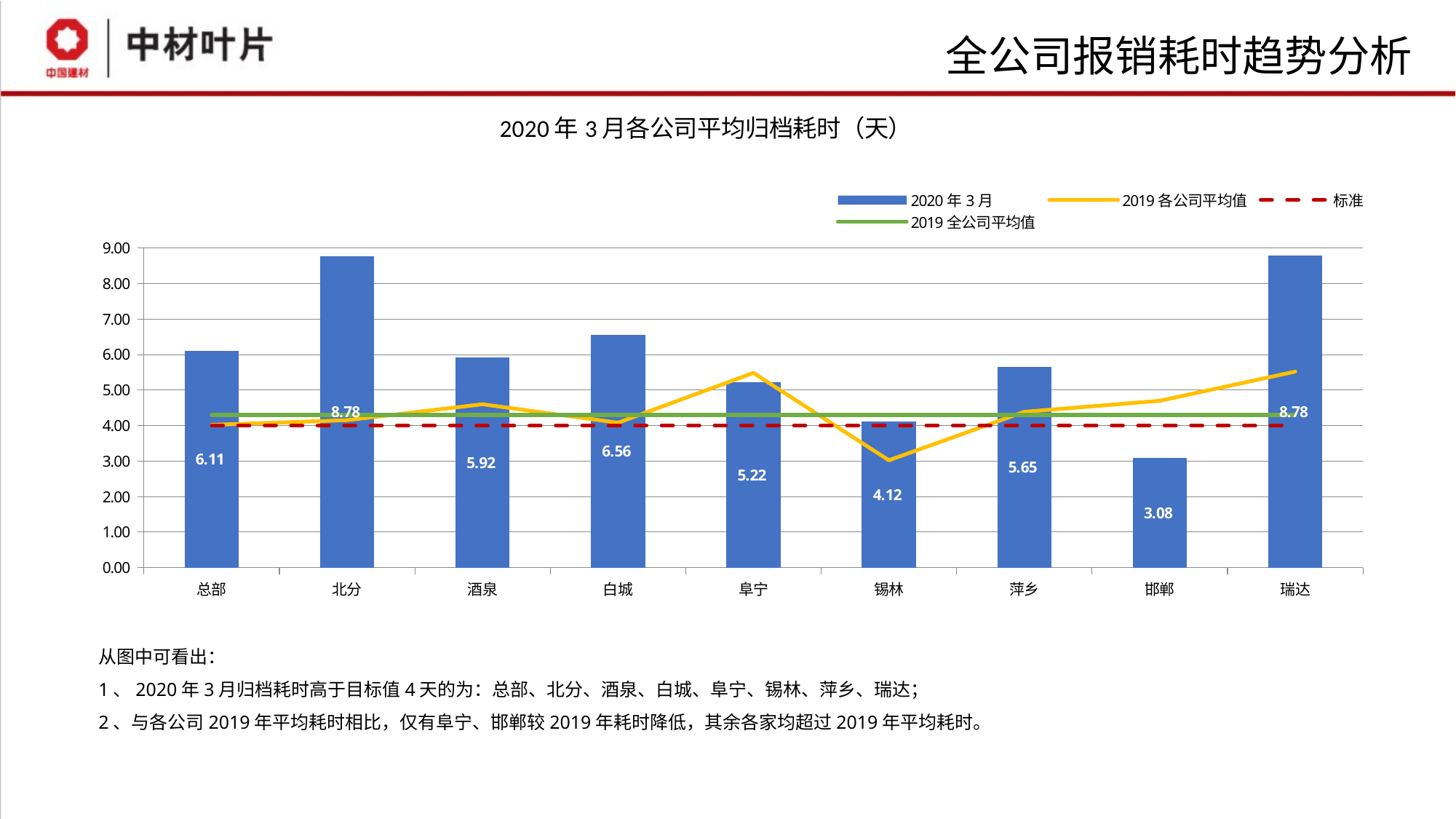
What is the title of the chart? 2020年3月各公司平均归档耗时（天） What is the 2020年3月 value for 锡林? 4.12 What is the difference between the 2020年3月 values for 白城 and 酒泉? 0.64 How many series does the legend list? 4 Which has the larger 2020年3月 value, 萍乡 or 阜宁? 萍乡 Is the 标准 line greater or less than 5.00? less What is the difference between the 2020年3月 values for 总部 and 阜宁? 0.89 Is the 2020年3月 value for 邯郸 greater or less than 4.00? less What is the 2020年3月 value for 总部? 6.11 What is the 2020年3月 value for 邯郸? 3.08 Which company has the lowest 2020年3月 value? 邯郸 How many companies are shown on the x axis? 9